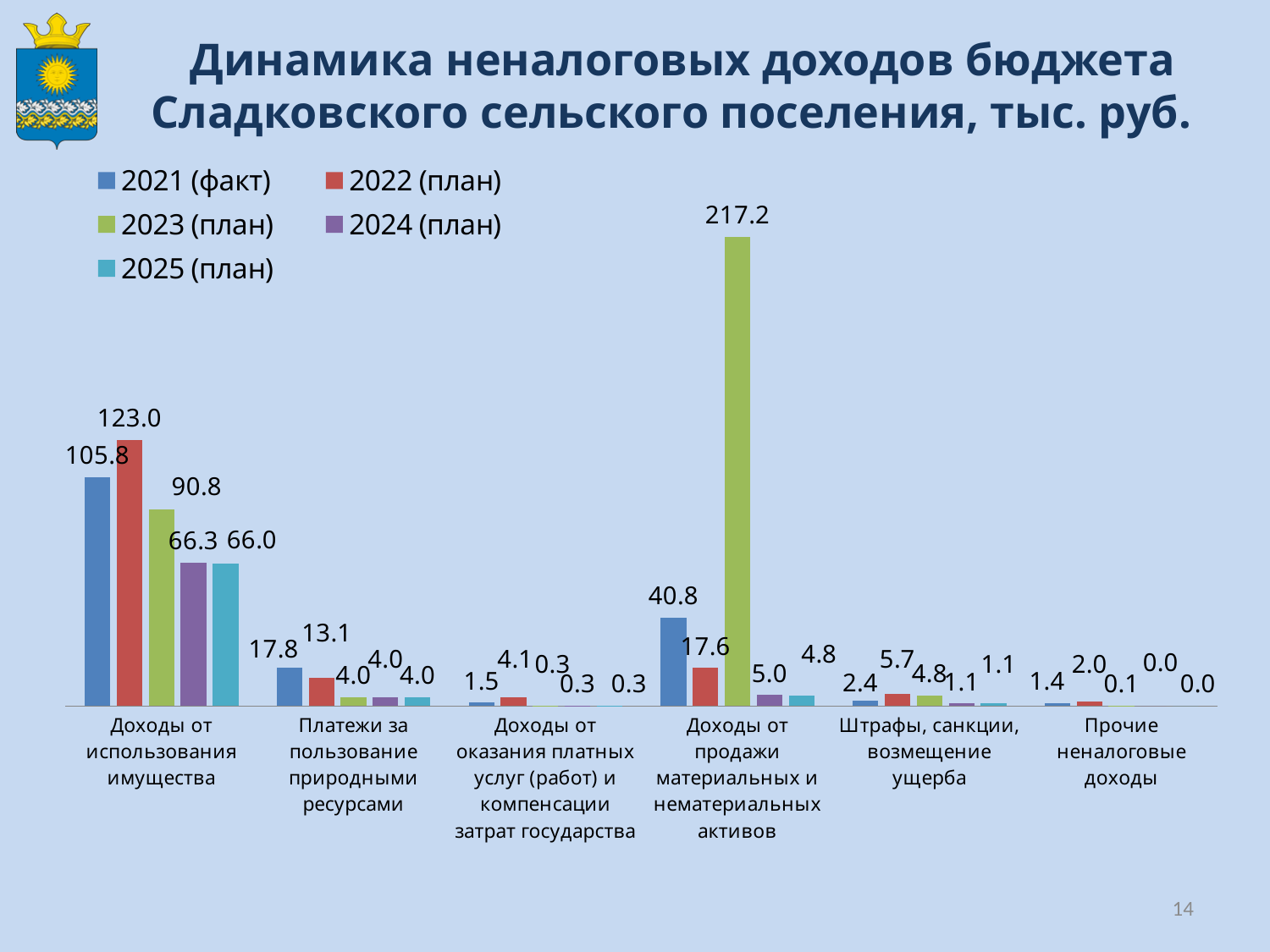
What is the value for 2023 (план) in the category «Доходы от продажи материальных и нематериальных активов»? 217.2 How many categories are shown on the x axis? 6 Which series has the highest value in the category «Доходы от использования имущества»? 2022 (план) How many series does the legend list? 5 What is the value for 2025 (план) in the category «Прочие неналоговые доходы»? 0.0 What is the value for 2021 (факт) in the category «Доходы от использования имущества»? 105.8 What is the value for 2022 (план) in the category «Штрафы, санкции, возмещение ущерба»? 5.7 What is the title of the chart? Динамика неналоговых доходов бюджета Сладковского сельского поселения, тыс. руб. Which is larger in the category «Доходы от продажи материальных и нематериальных активов»: the 2021 (факт) value or the 2022 (план) value? 2021 (факт) What kind of chart is shown on the slide? Bar chart What is the difference between the 2022 (план) and 2021 (факт) values in the category «Доходы от использования имущества»? 17.2